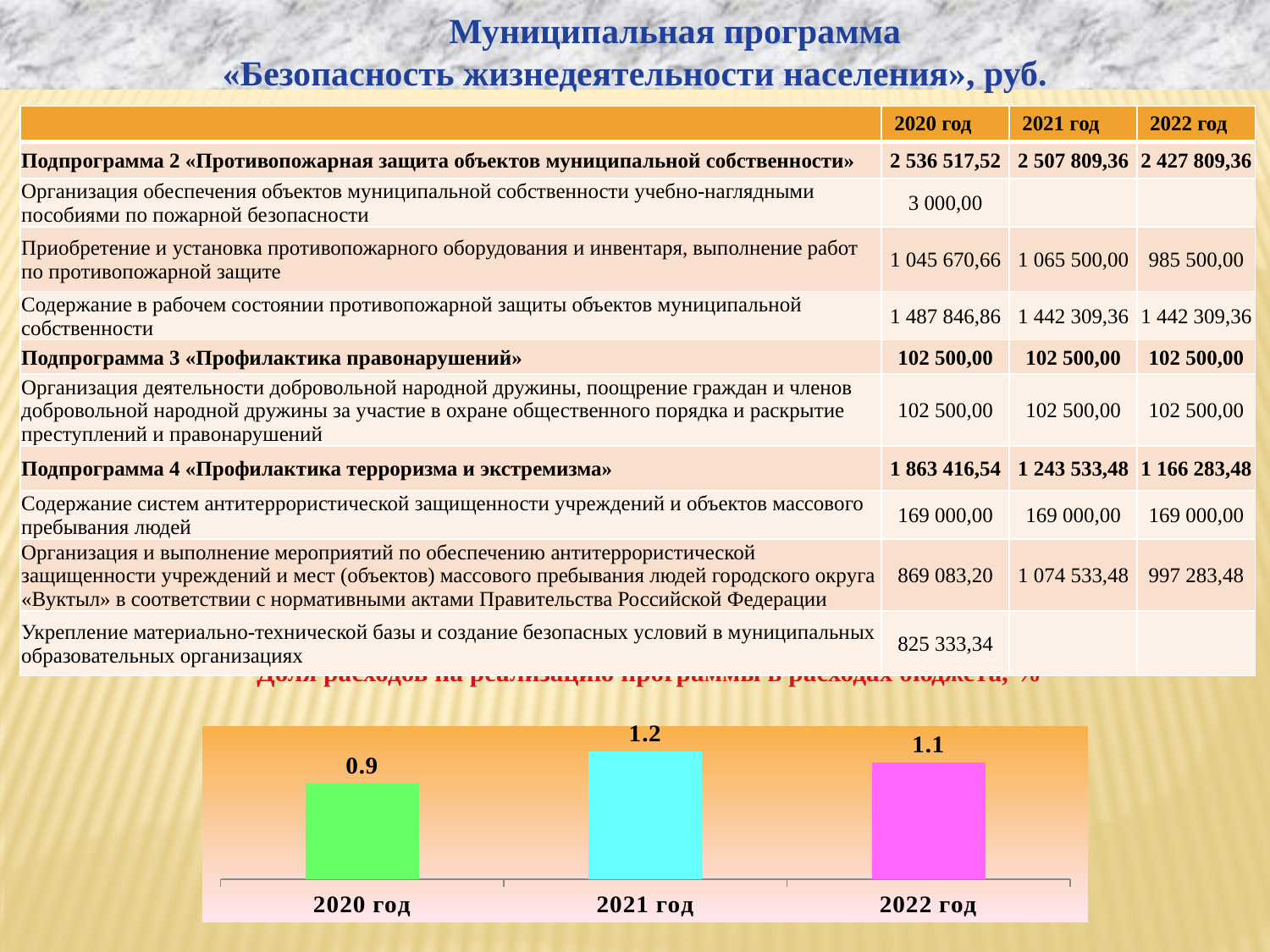
Which year has the lowest value in the bar chart? 2020 год What type of chart is shown at the bottom of the slide? bar chart What is the value shown for 2021 год in the bar chart? 1.2 What is the difference between the values for 2021 год and 2020 год in the bar chart? 0.3 What colour is the bar for 2021 год in the bar chart? cyan Which year has the highest value in the bar chart? 2021 год What is the value shown for 2020 год in the bar chart? 0.9 In the bar chart, which is larger: the value for 2022 год or the value for 2020 год? 2022 год What is the difference between the values for 2021 год and 2022 год in the bar chart? 0.1 What is the value shown for 2022 год in the bar chart? 1.1 Does the value in the bar chart rise or fall from 2020 год to 2021 год? rise How many bars are shown in the bar chart? 3